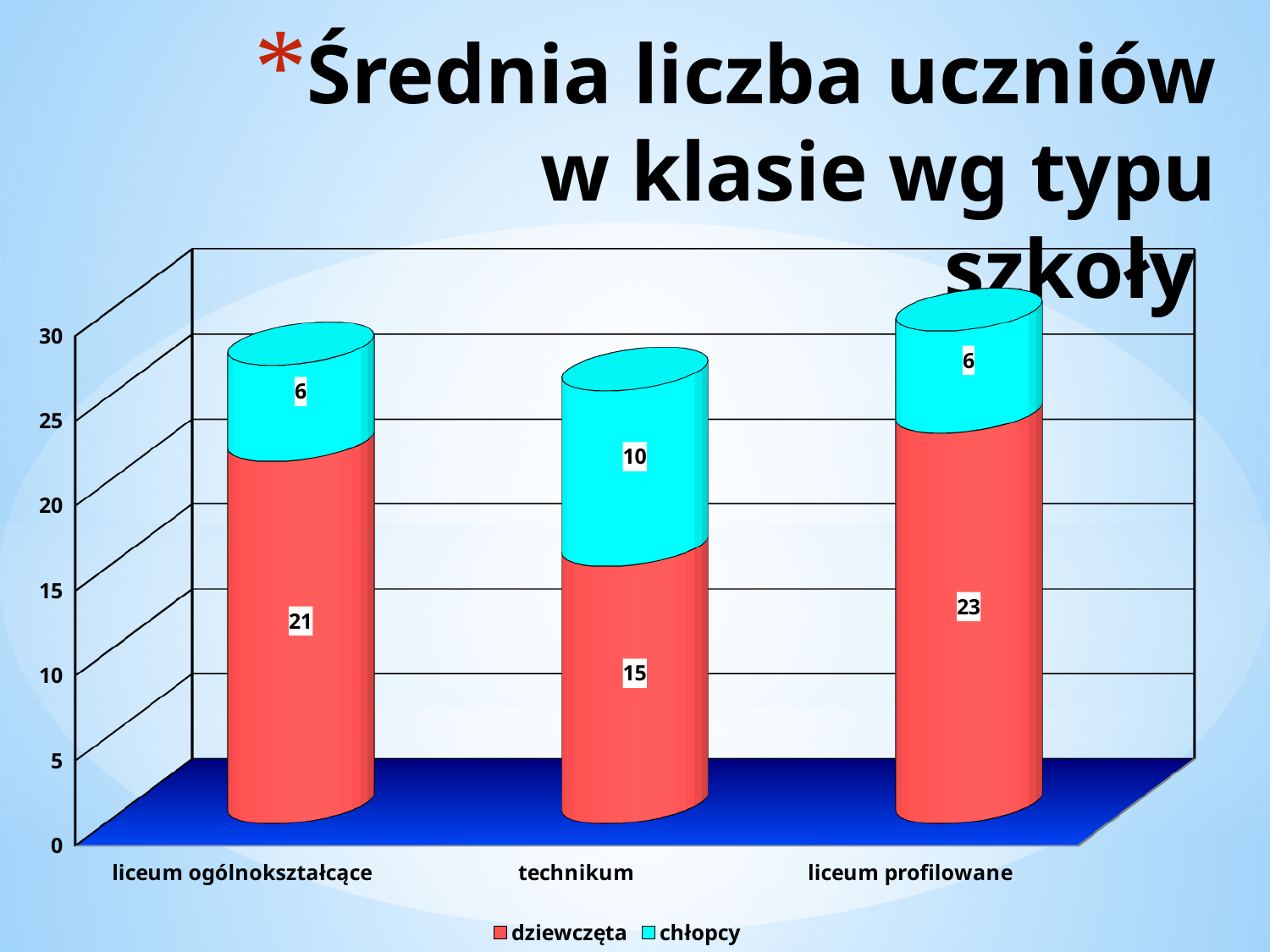
What kind of chart is shown on the slide? stacked bar chart What is the difference between the dziewczęta values for liceum profilowane and technikum? 8 What is the total of the stacked bar for technikum? 25 What is the value for chłopcy in liceum profilowane? 6 What is the value for dziewczęta in liceum ogólnokształcące? 21 Which is larger: the dziewczęta value for liceum ogólnokształcące or for liceum profilowane? liceum profilowane What is the value for dziewczęta in technikum? 15 Which school type has the lowest value for dziewczęta? technikum How many school types are shown on the x axis? 3 How many series does the legend list? 2 What is the total of the stacked bar for liceum profilowane? 29 Which school type has the highest value for chłopcy? technikum